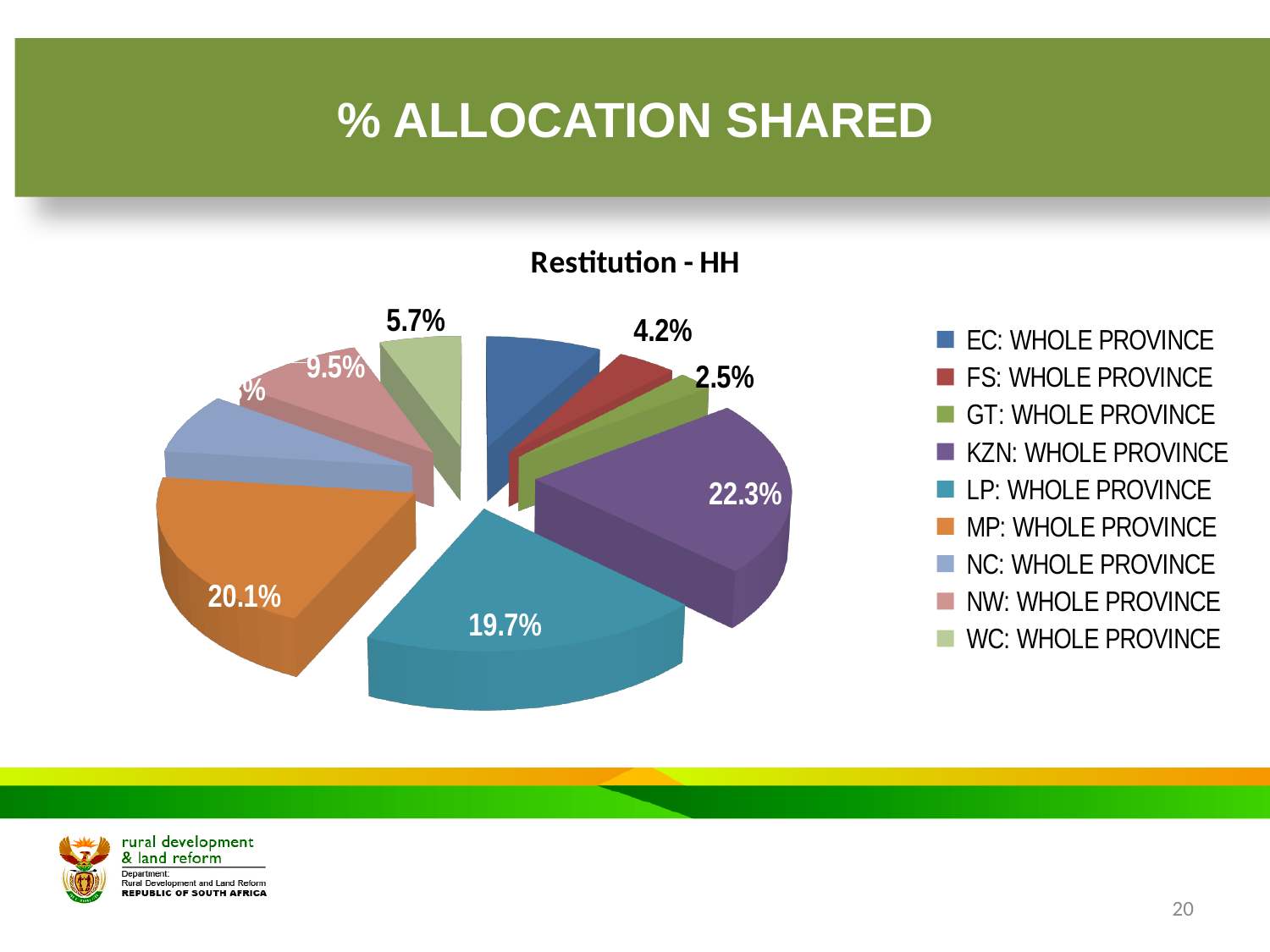
Which is larger, the share for KZN: WHOLE PROVINCE or MP: WHOLE PROVINCE? KZN: WHOLE PROVINCE What is the value for GT: WHOLE PROVINCE? 2.5% What is the value for NW: WHOLE PROVINCE? 9.5% What is the value for LP: WHOLE PROVINCE? 19.7% What is the value for WC: WHOLE PROVINCE? 5.7% What kind of chart is shown on the slide? pie chart What is the difference between the shares for KZN: WHOLE PROVINCE and LP: WHOLE PROVINCE? 2.6% What is the value for MP: WHOLE PROVINCE? 20.1% Which province has the largest share of the pie? KZN: WHOLE PROVINCE What is the title of the chart? Restitution - HH How many categories does the legend list? 9 What share of the pie does KZN: WHOLE PROVINCE have? 22.3%